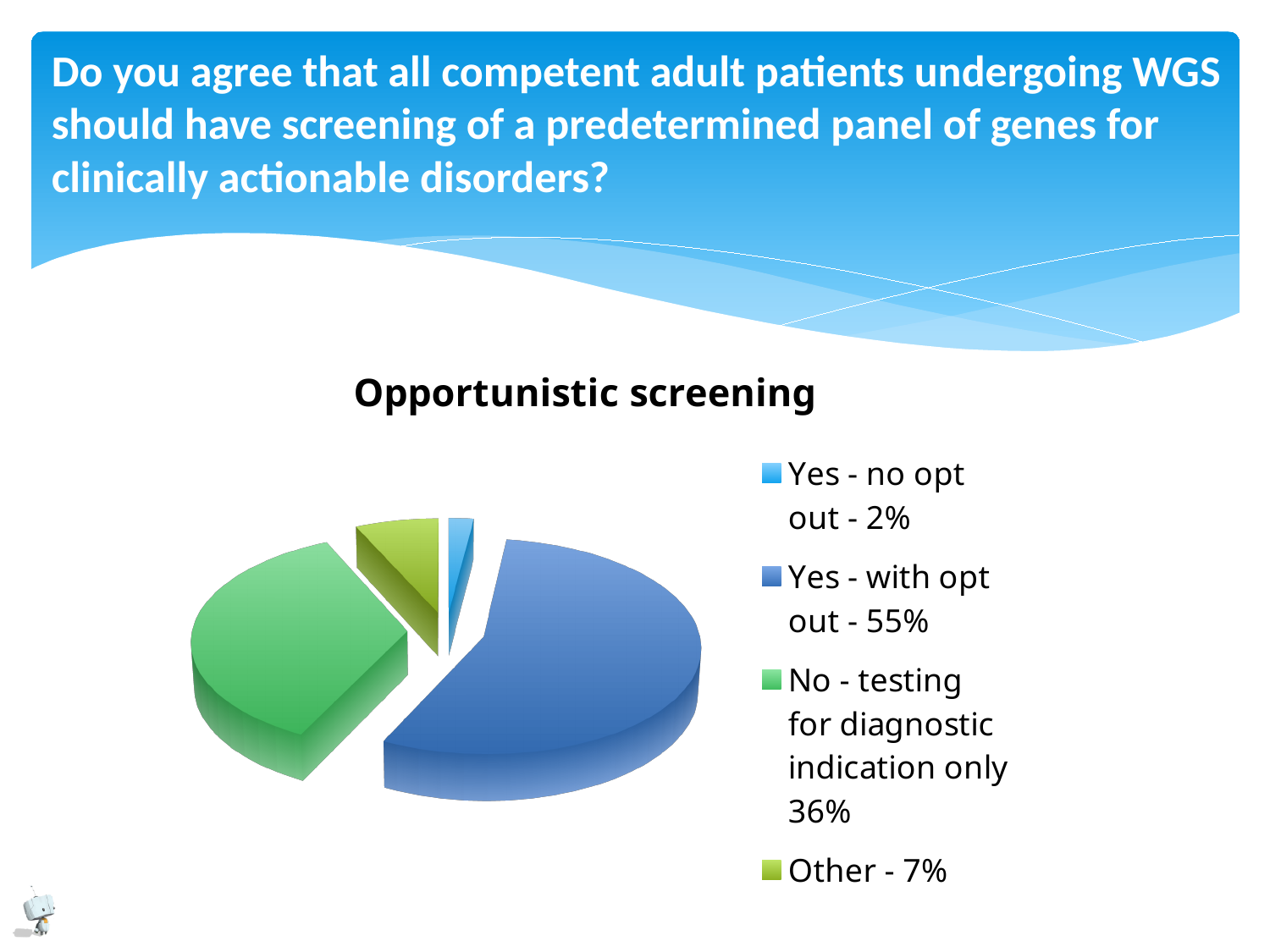
How many categories does the legend list? 4 What percentage of respondents chose "Yes - no opt out"? 2% What colour is the slice for "No - testing for diagnostic indication only"? Green What kind of chart is shown on the slide? Pie chart Which is larger: the share for "Other" or the share for "Yes - no opt out"? Other Which response has the smallest share of the pie? Yes - no opt out Which response has the largest share of the pie? Yes - with opt out What percentage of respondents chose "No - testing for diagnostic indication only"? 36% What is the difference in percentage points between "Yes - with opt out" and "No - testing for diagnostic indication only"? 19 What percentage of respondents chose "Yes - with opt out"? 55% What is the title of the chart? Opportunistic screening What percentage of respondents chose "Other"? 7%